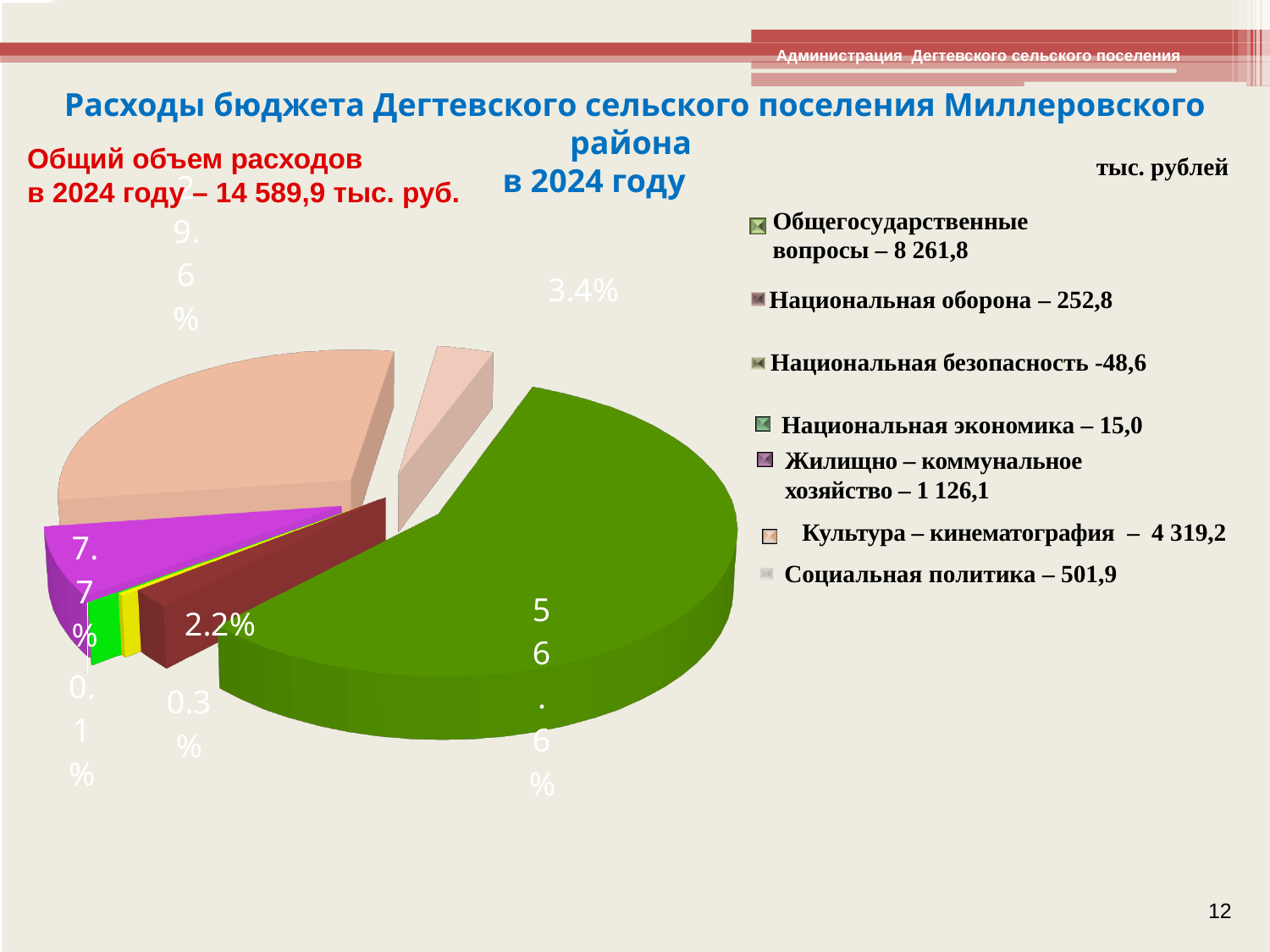
What is the difference between Общегосударственные вопросы and Культура – кинематография? 3 942,6 Which category has the largest expenditure? Общегосударственные вопросы What kind of chart is shown on the slide? pie chart What is the value for Общегосударственные вопросы? 8 261,8 Which category has the smallest expenditure? Национальная экономика What share of the pie does the largest slice (Общегосударственные вопросы) represent? 56.6% What is the value for Национальная безопасность? 48,6 What is the total volume of expenditures in 2024 stated on the slide? 14 589,9 тыс. руб. Which is larger: Национальная оборона or Социальная политика? Социальная политика What is the value for Культура – кинематография? 4 319,2 What is the value for Жилищно – коммунальное хозяйство? 1 126,1 How many expenditure categories does the legend list? 7